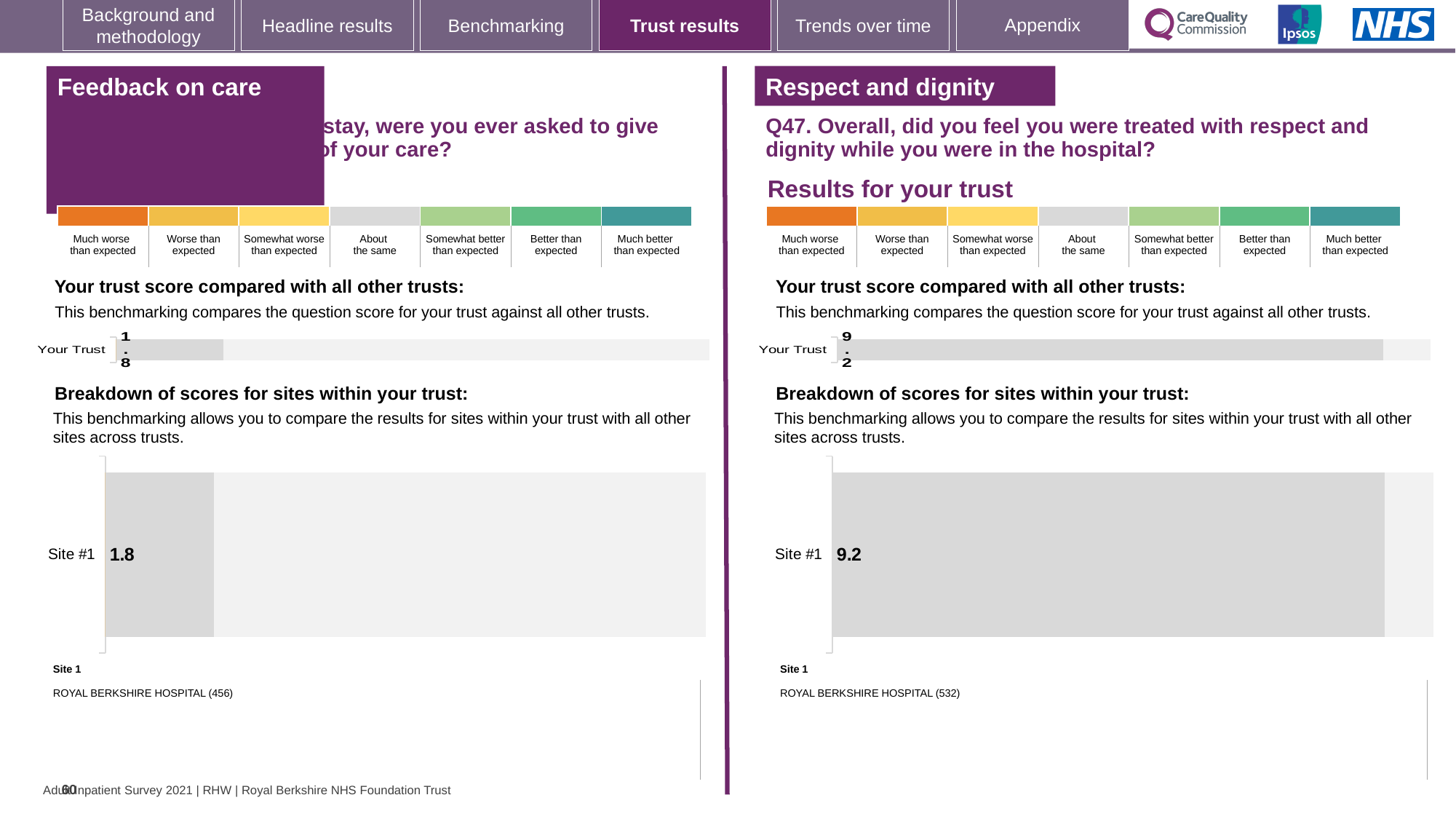
Which site is listed as Site 1 beneath the right-hand 'Respect and dignity' breakdown chart? ROYAL BERKSHIRE HOSPITAL (532) Which is larger: the 'Your Trust' score in the left-hand 'Feedback on care' chart or the 'Your Trust' score in the right-hand 'Respect and dignity' chart? Respect and dignity What is the difference between the Site #1 score in the right-hand 'Respect and dignity' breakdown chart and the Site #1 score in the left-hand 'Feedback on care' breakdown chart? 7.4 In the 'Breakdown of scores for sites within your trust' chart on the right-hand side of the slide, what is the value for Site #1? 9.2 In the 'Breakdown of scores for sites within your trust' chart on the left-hand side of the slide, what is the value for Site #1? 1.8 In the left-hand 'Feedback on care' section, is the Site #1 score the same as the 'Your Trust' score? Yes What type of chart is used to show the Site #1 score in the left-hand 'Feedback on care' breakdown chart? Bar chart How many sites are shown in the 'Breakdown of scores for sites within your trust' chart on the right-hand side of the slide? 1 On the right-hand 'Respect and dignity' section, what is the score shown for 'Your Trust' in the trust comparison chart? 9.2 On the left-hand 'Feedback on care' section, what is the score shown for 'Your Trust' in the trust comparison chart? 1.8 How many sites are shown in the 'Breakdown of scores for sites within your trust' chart on the left-hand side of the slide? 1 Which site is listed as Site 1 beneath the left-hand 'Feedback on care' breakdown chart? ROYAL BERKSHIRE HOSPITAL (456)